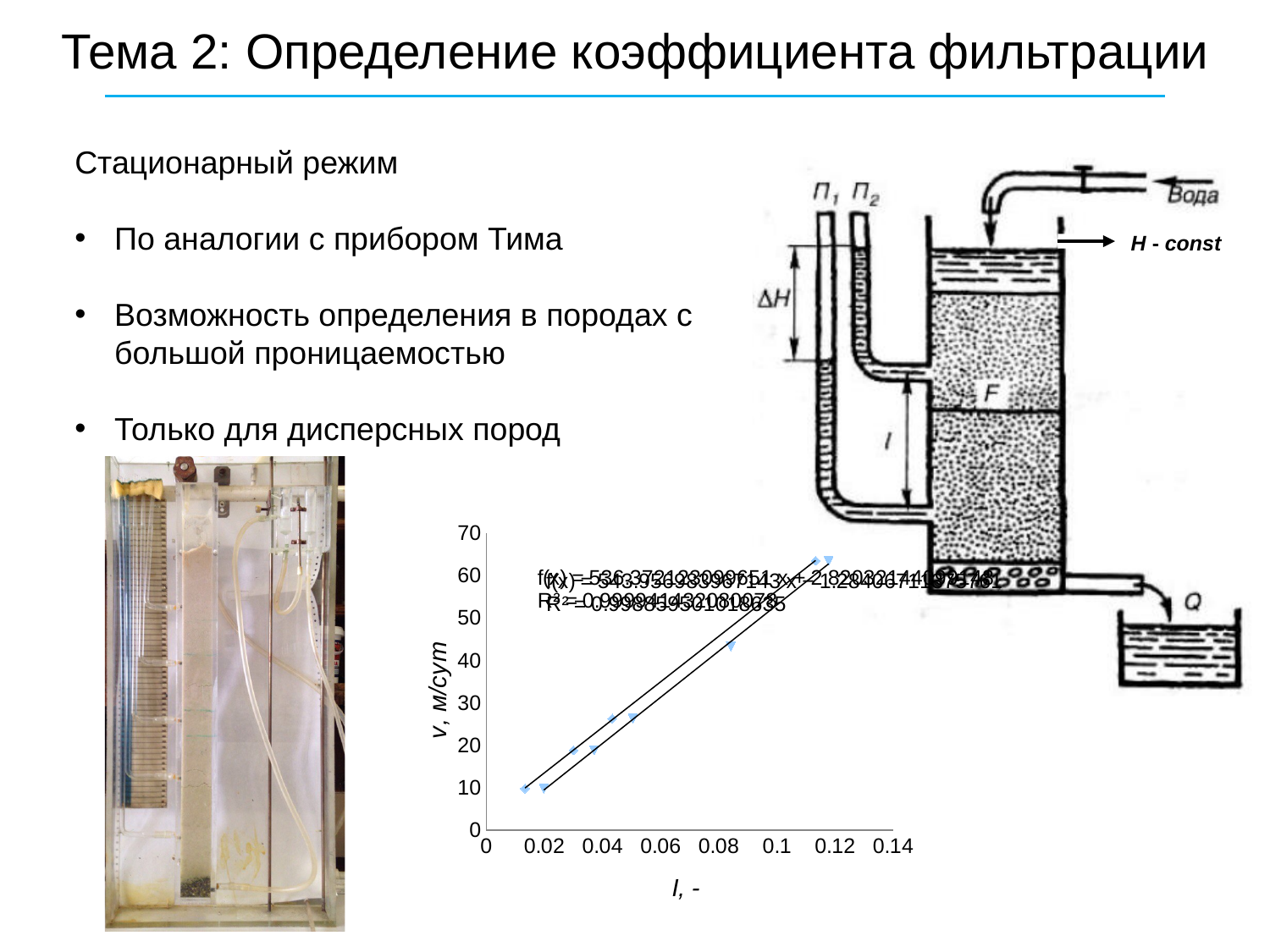
What is the label of the x axis of the scatter chart? I, - In the scatter chart, which has the larger v value: the point near I = 0.085 or the points near I = 0.045? the point near I = 0.085 In the scatter chart, is the value of v for the points near I = 0.045 greater or less than 20? greater In the scatter chart, is the value of v for the points near I = 0.015 greater or less than 20? less In the scatter chart, is the value of v for the points near I = 0.045 greater or less than 30? less What is the label of the y axis of the scatter chart? v, м/сут In the scatter chart, do the values of v rise or fall as I increases along the x axis? rise What kind of chart is shown at the bottom of the slide? scatter chart